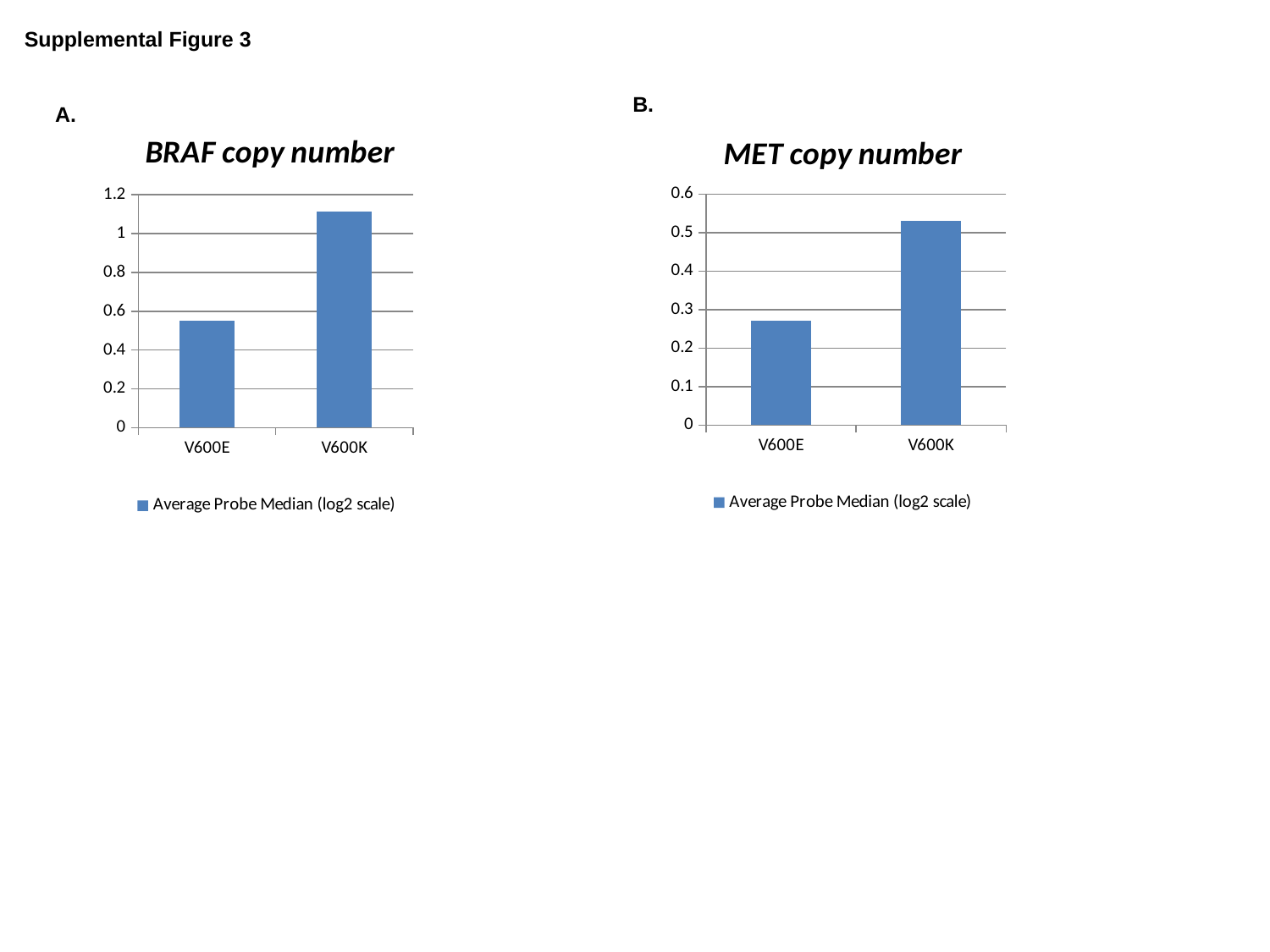
In the MET copy number chart, which category has the lower bar? V600E How many series does the legend of the BRAF copy number chart list? 1 In the BRAF copy number chart, is the value for V600K greater or less than 1? greater In the BRAF copy number chart, which category has the higher bar? V600K What is the legend entry shown below the MET copy number chart? Average Probe Median (log2 scale) In the MET copy number chart, which category has the higher bar? V600K In the MET copy number chart, is the value for V600E greater or less than 0.2? greater What kind of chart is the BRAF copy number chart? bar chart How many categories are shown on the x axis of the MET copy number chart? 2 In the BRAF copy number chart, is the value for V600E greater or less than 0.4? greater In the BRAF copy number chart, which category has the lower bar? V600E